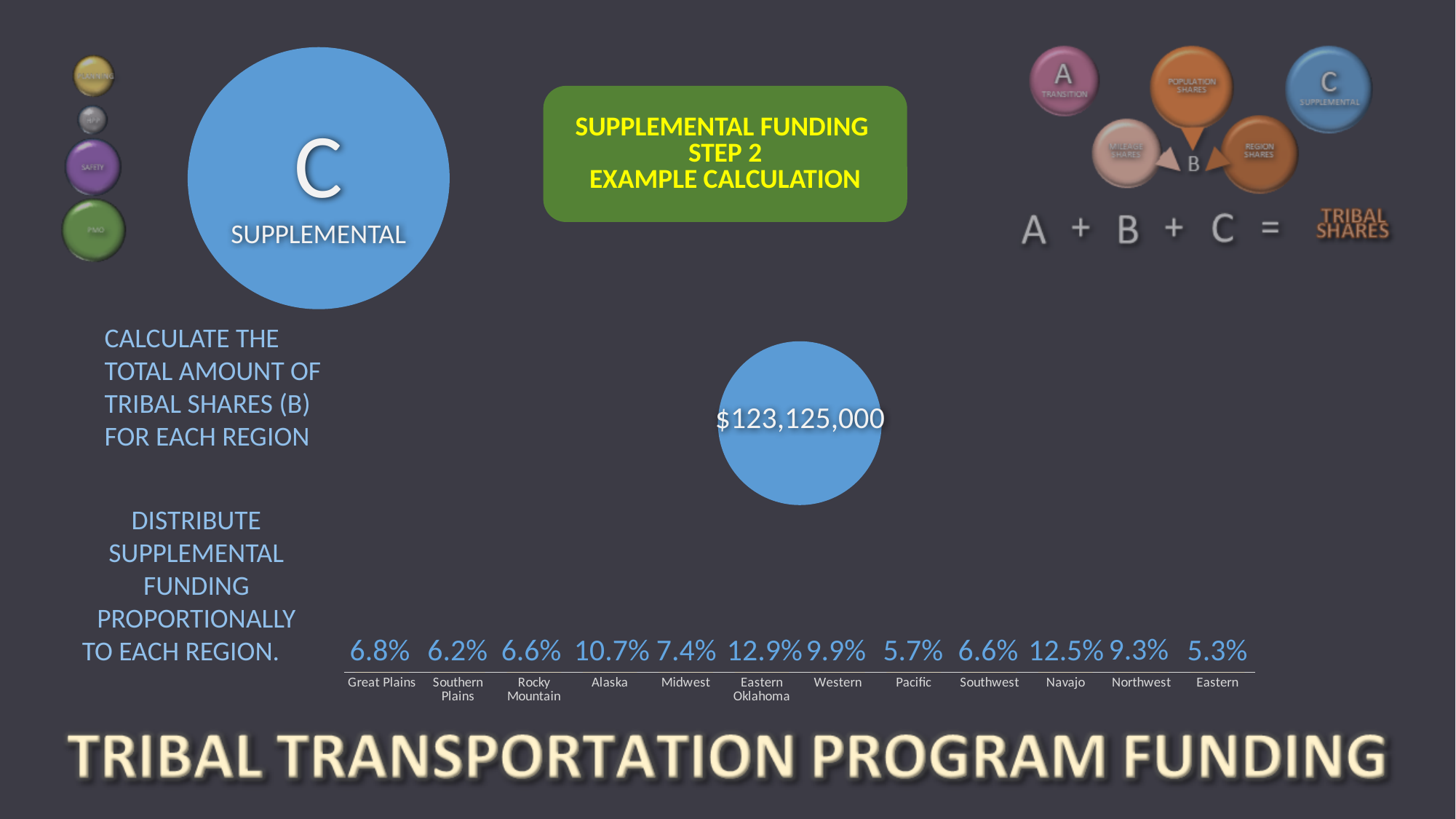
What is the value shown for Alaska? 10.7% What is the difference between the values for Alaska and Great Plains? 3.9% What is the value shown for Navajo? 12.5% What is the value shown for Southern Plains? 6.2% What total amount is shown in the blue circle above the chart? $123,125,000 Which region has the lowest value? Eastern Which region has the highest value? Eastern Oklahoma What is the value shown for Eastern Oklahoma? 12.9% How many regions are listed along the bottom of the chart? 12 What is the difference between the values for Navajo and Northwest? 3.2% What is the value shown for Pacific? 5.7% Which is larger, the value for Western or the value for Midwest? Western